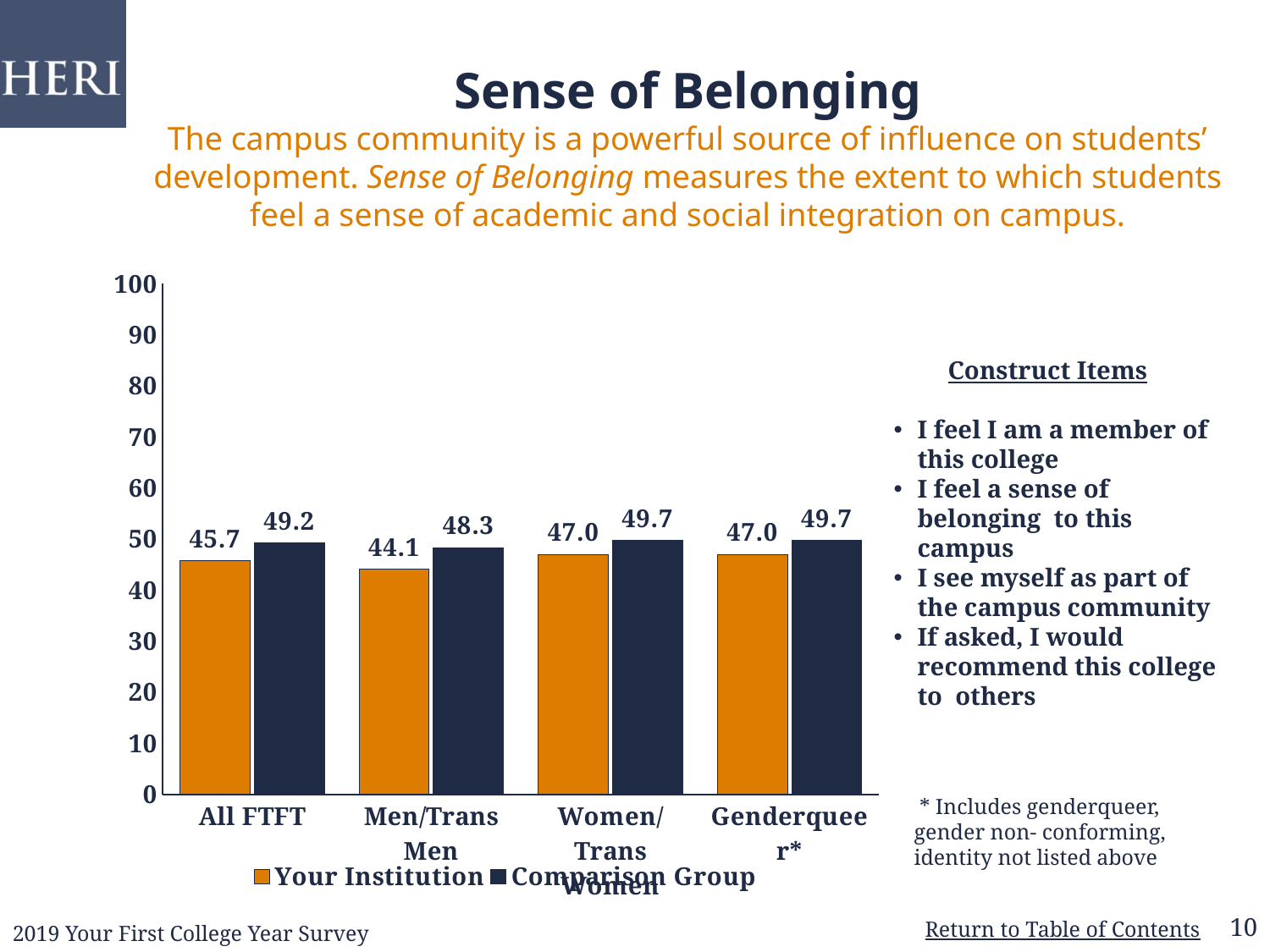
What kind of chart is shown on the slide? Bar chart For Women/Trans Women, which is larger: Your Institution or Comparison Group? Comparison Group What is the Your Institution value for Women/Trans Women? 47.0 What is the Comparison Group value for Genderqueer*? 49.7 What is the Comparison Group value for Men/Trans Men? 48.3 Which category has the lowest Your Institution value? Men/Trans Men What is the Your Institution value for All FTFT? 45.7 What is the difference between the Comparison Group and Your Institution values for Men/Trans Men? 4.2 How many categories are shown on the x axis? 4 What is the difference between the Comparison Group and Your Institution values for All FTFT? 3.5 How many series does the legend list? 2 Which category has the lowest Comparison Group value? Men/Trans Men